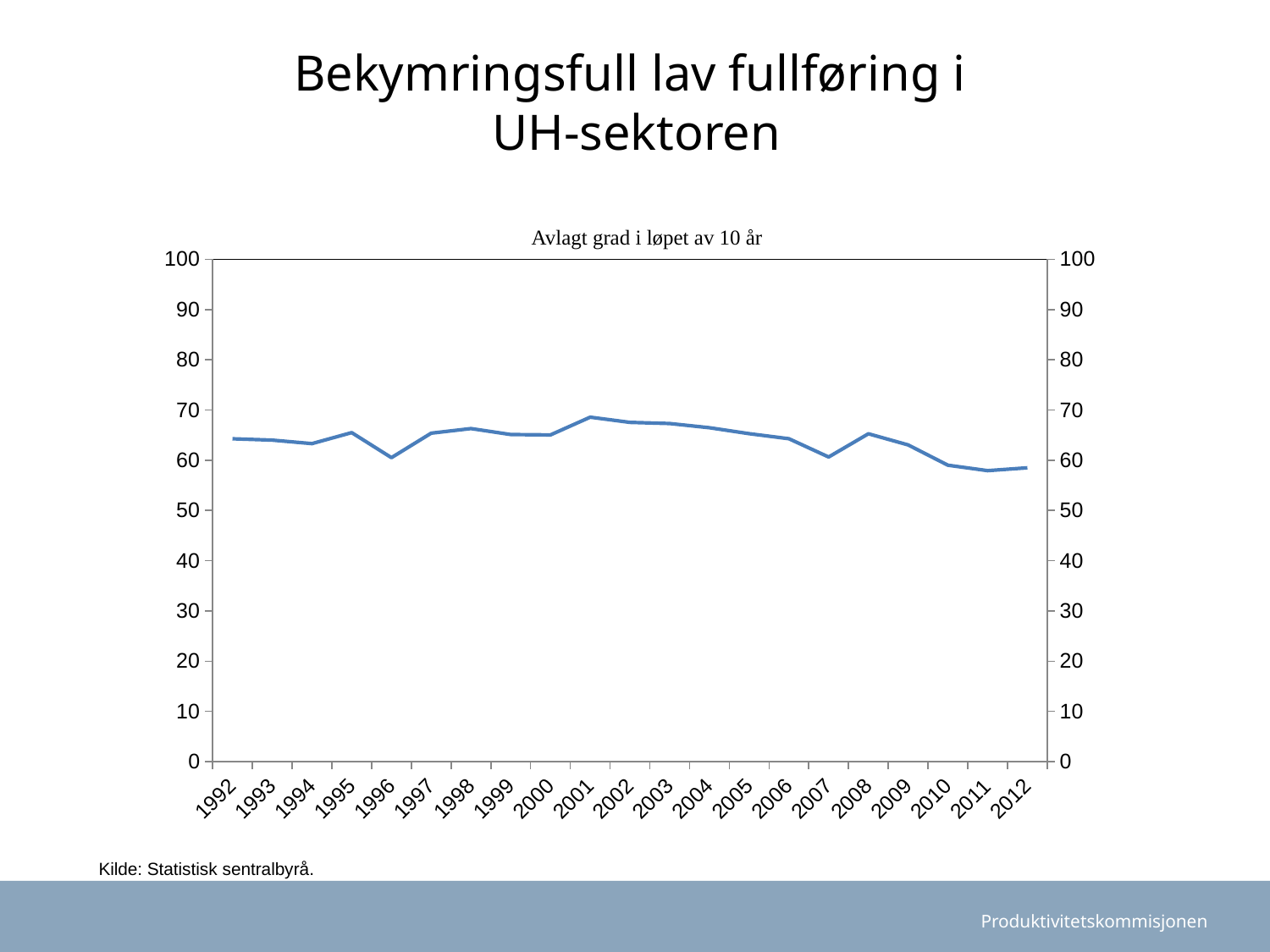
Is the value for 1996 greater or less than 50? greater Is the value for 2001 greater or less than 60? greater Which is larger, the value for 2001 or the value for 2011? 2001 What is the title of the chart? Avlagt grad i løpet av 10 år How many years are plotted along the x axis of the chart? 21 Is the value for 2011 greater or less than 60? less What kind of chart is shown on the slide? line chart Do the values rise or fall from 2001 to 2012? fall Which year has the highest value in the chart? 2001 What source is cited below the chart? Statistisk sentralbyrå